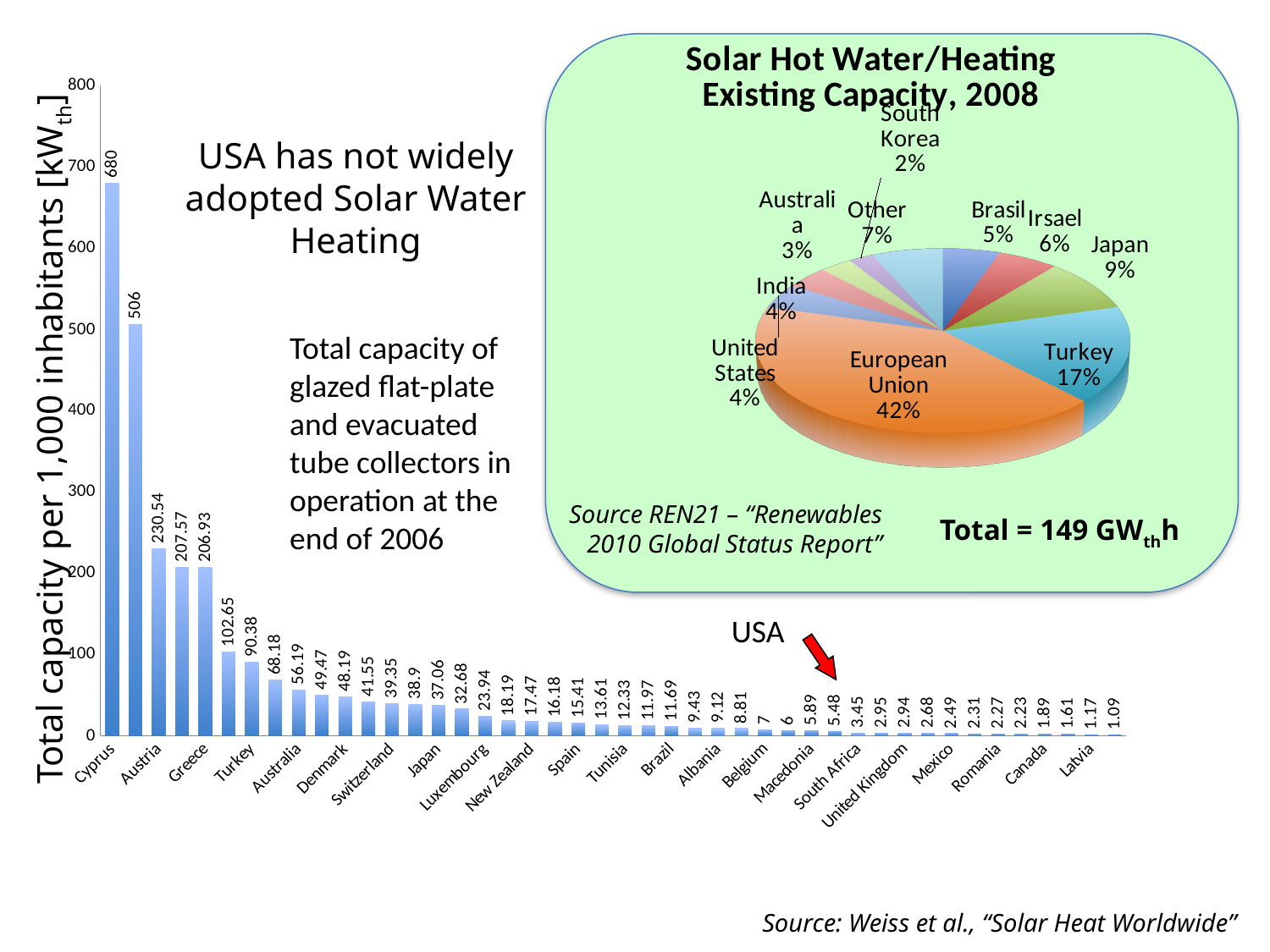
In the pie chart titled 'Solar Hot Water/Heating Existing Capacity, 2008', which has the larger share, Japan or Israel? Japan In the pie chart titled 'Solar Hot Water/Heating Existing Capacity, 2008', what share does Turkey hold? 17% In the pie chart titled 'Solar Hot Water/Heating Existing Capacity, 2008', which region has the largest slice? European Union What kind of chart is the chart on the left showing total capacity per 1,000 inhabitants? Bar chart In the pie chart titled 'Solar Hot Water/Heating Existing Capacity, 2008', what total capacity is stated below the chart? 149 GWth h In the pie chart titled 'Solar Hot Water/Heating Existing Capacity, 2008', how many slices are shown? 10 In the pie chart titled 'Solar Hot Water/Heating Existing Capacity, 2008', what share does the European Union hold? 42% In the bar chart on the left showing total capacity per 1,000 inhabitants, what is the value of the bar the USA arrow points to? 5.48 In the bar chart on the left showing total capacity per 1,000 inhabitants, which country has the highest value? Cyprus In the bar chart on the left showing total capacity per 1,000 inhabitants, what is the value for Cyprus? 680 In the pie chart titled 'Solar Hot Water/Heating Existing Capacity, 2008', how many percentage points larger is the European Union's share than Turkey's? 25 In the pie chart titled 'Solar Hot Water/Heating Existing Capacity, 2008', which country has the smallest slice? South Korea